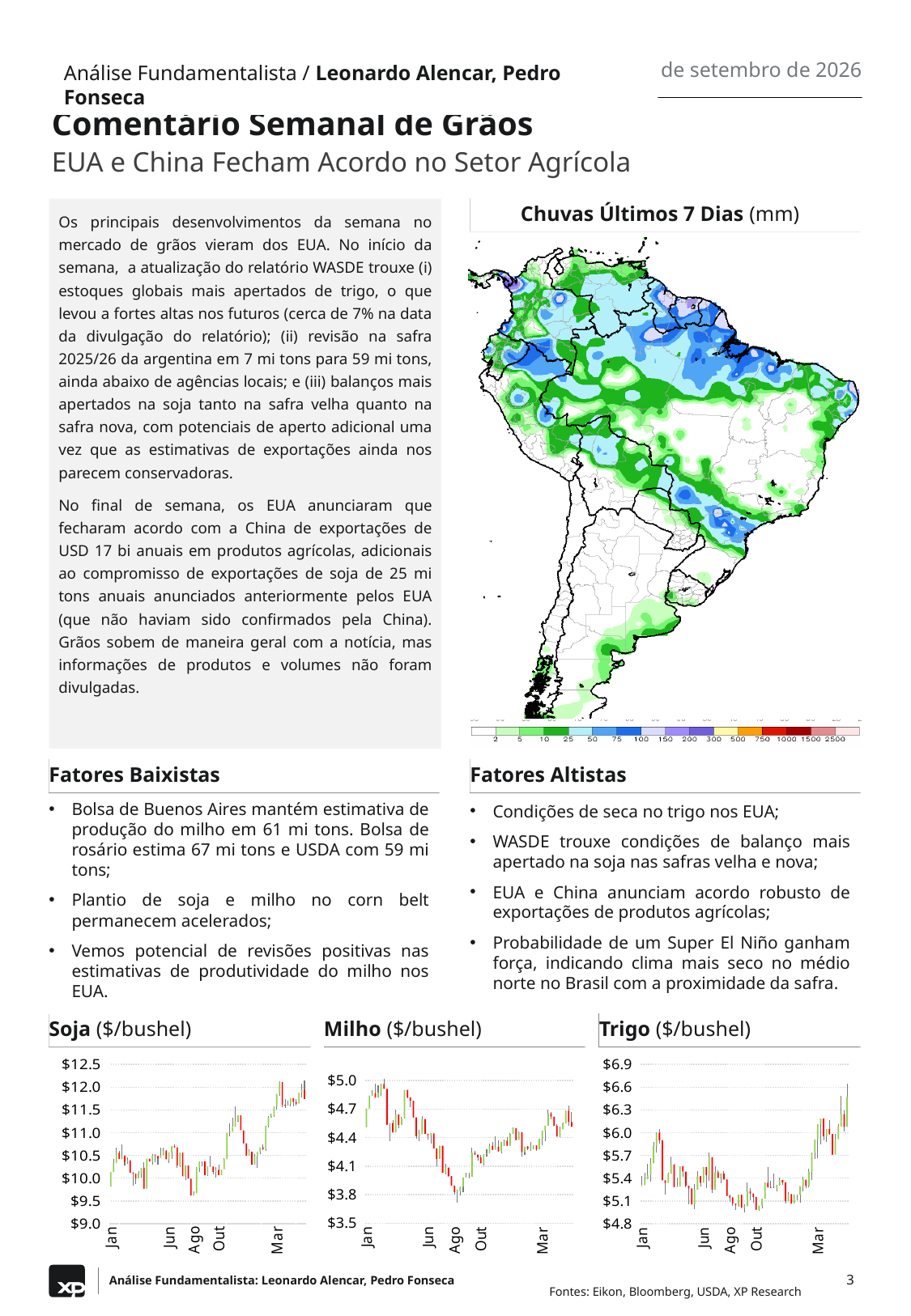
In the Trigo ($/bushel) chart, is the most recent price (at Mar) greater or less than $6.3? greater In the Soja ($/bushel) chart, do prices rise or fall overall from Jan to Mar? rise In the Trigo ($/bushel) chart, do prices rise or fall from Out to Mar? rise How many month labels are shown on the x axis of the Trigo ($/bushel) chart? 5 In the Soja ($/bushel) chart, is the lowest price around Jun greater or less than $10.0? greater In the Milho ($/bushel) chart, do prices rise or fall from Jan to Ago? fall In the Milho ($/bushel) chart, is the lowest price around Ago greater or less than $4.1? less What is the highest value shown on the y axis of the Milho ($/bushel) chart? $5.0 What kind of chart is the Soja ($/bushel) chart? candlestick chart What unit is used for the prices in the Soja, Milho and Trigo charts? $/bushel